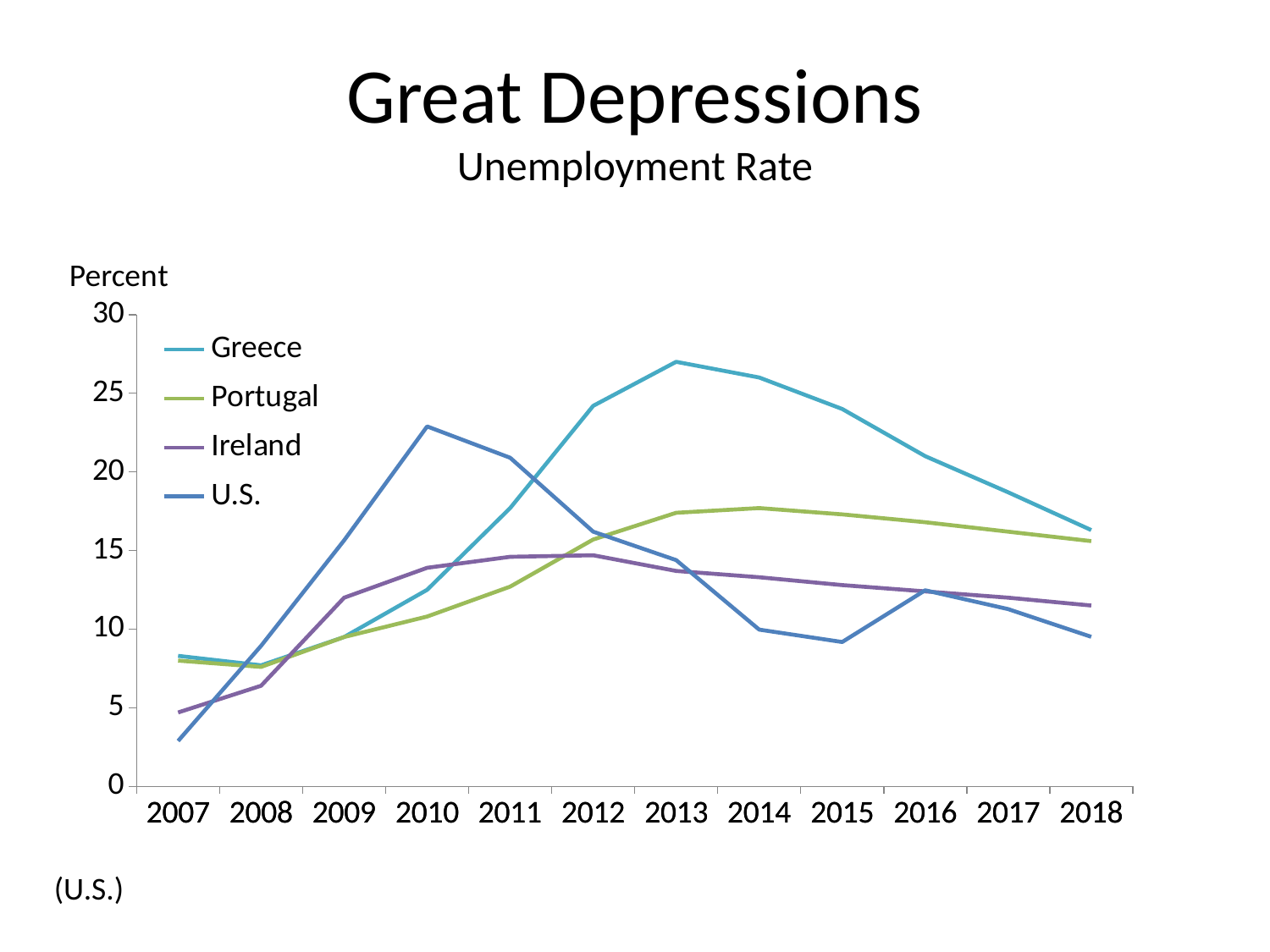
In which year does the Greece line reach its peak? 2013 Is the value for Greece in 2013 greater or less than 25? greater What kind of chart is shown on the slide? Line chart Is the value for Portugal in 2014 greater or less than 15? greater Which series reaches the highest unemployment rate on the chart? Greece In which year does the U.S. line reach its peak? 2010 Is the value for the U.S. in 2007 greater or less than 5? less Does the Greece line rise or fall from 2013 to 2018? Fall How many series does the legend list? 4 What is the label on the vertical axis of the chart? Percent How many years are shown along the x axis? 12 In 2010, which has the higher unemployment rate, Greece or the U.S.? U.S.